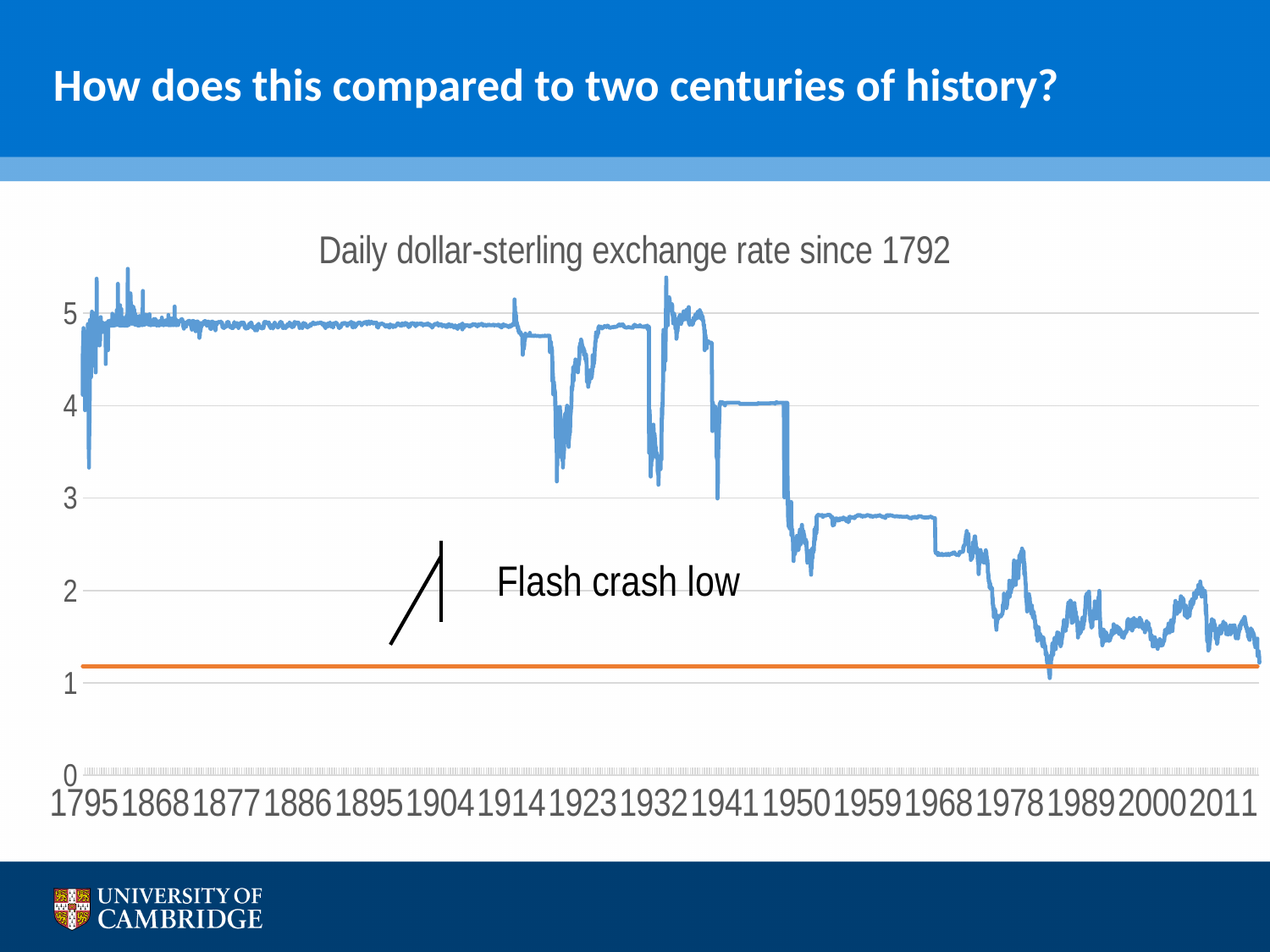
What is the title of the chart? Daily dollar-sterling exchange rate since 1792 What kind of chart is shown on the slide? line chart What is the highest value shown on the y axis? 5 Is the exchange rate around 1877 greater or less than 4? greater Is the exchange rate around 2011 greater or less than 2? less Is the exchange rate around 1895 greater or less than 4? greater Overall, does the dollar-sterling exchange rate rise or fall from 1795 to 2011? fall Which is larger, the exchange rate around 1895 or around 2000? 1895 What does the orange horizontal line on the chart mark? Flash crash low How many year labels are shown on the x axis? 17